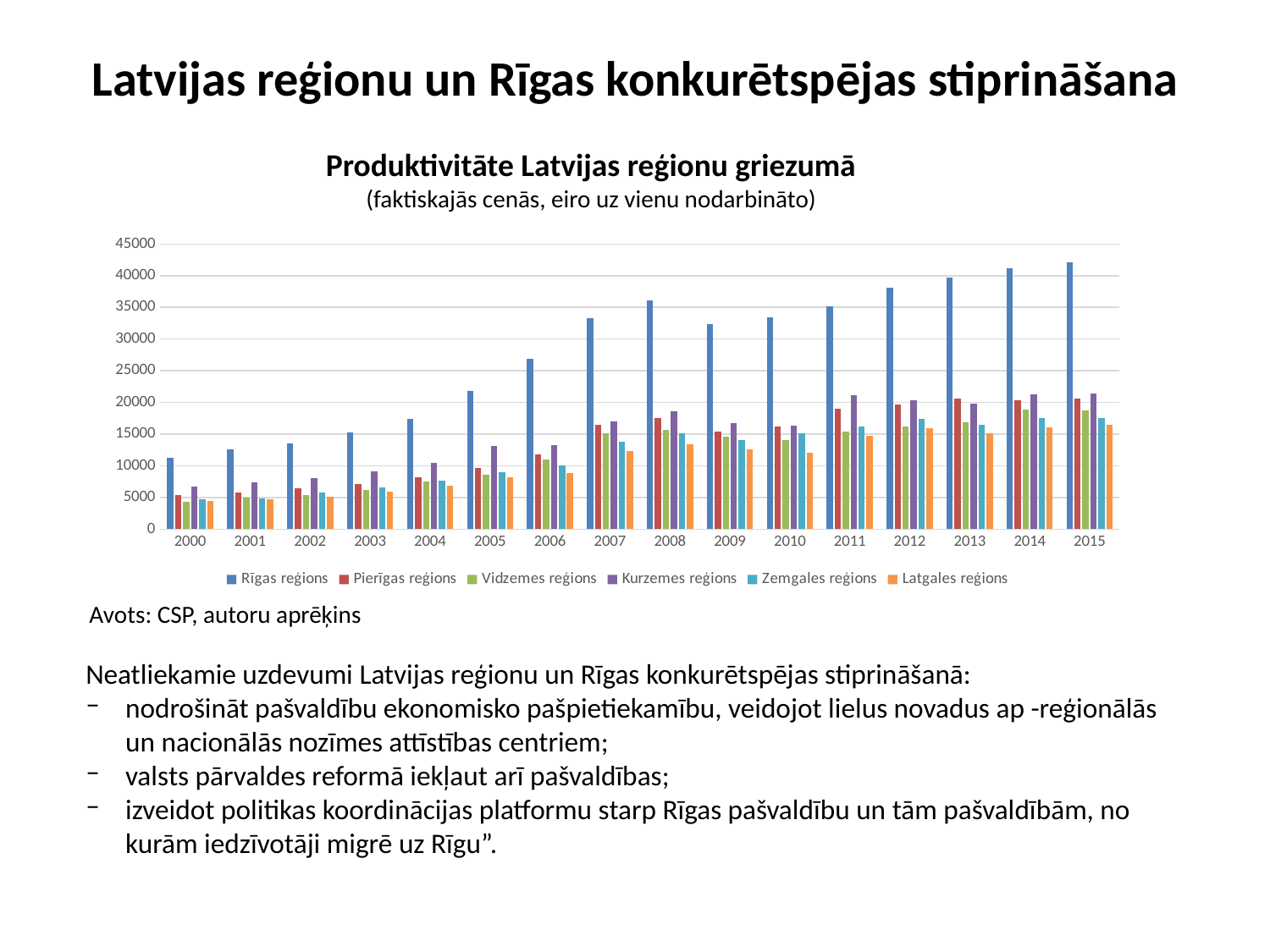
What kind of chart is shown on the slide? bar chart How many years are shown on the x axis? 16 Is the value for Rīgas reģions in 2015 greater or less than 40000? greater Does the value for Rīgas reģions generally rise or fall from 2000 to 2015? rise How many series does the legend list? 6 Is the value for Rīgas reģions in 2000 greater or less than 15000? less Is the value for Latgales reģions in 2015 greater or less than 15000? greater What is the title of the chart? Produktivitāte Latvijas reģionu griezumā Which is larger: the value for Rīgas reģions in 2008 or in 2009? 2008 Which region has the highest value in 2015? Rīgas reģions In which year is the value for Rīgas reģions lowest? 2000 In which year is the value for Rīgas reģions highest? 2015